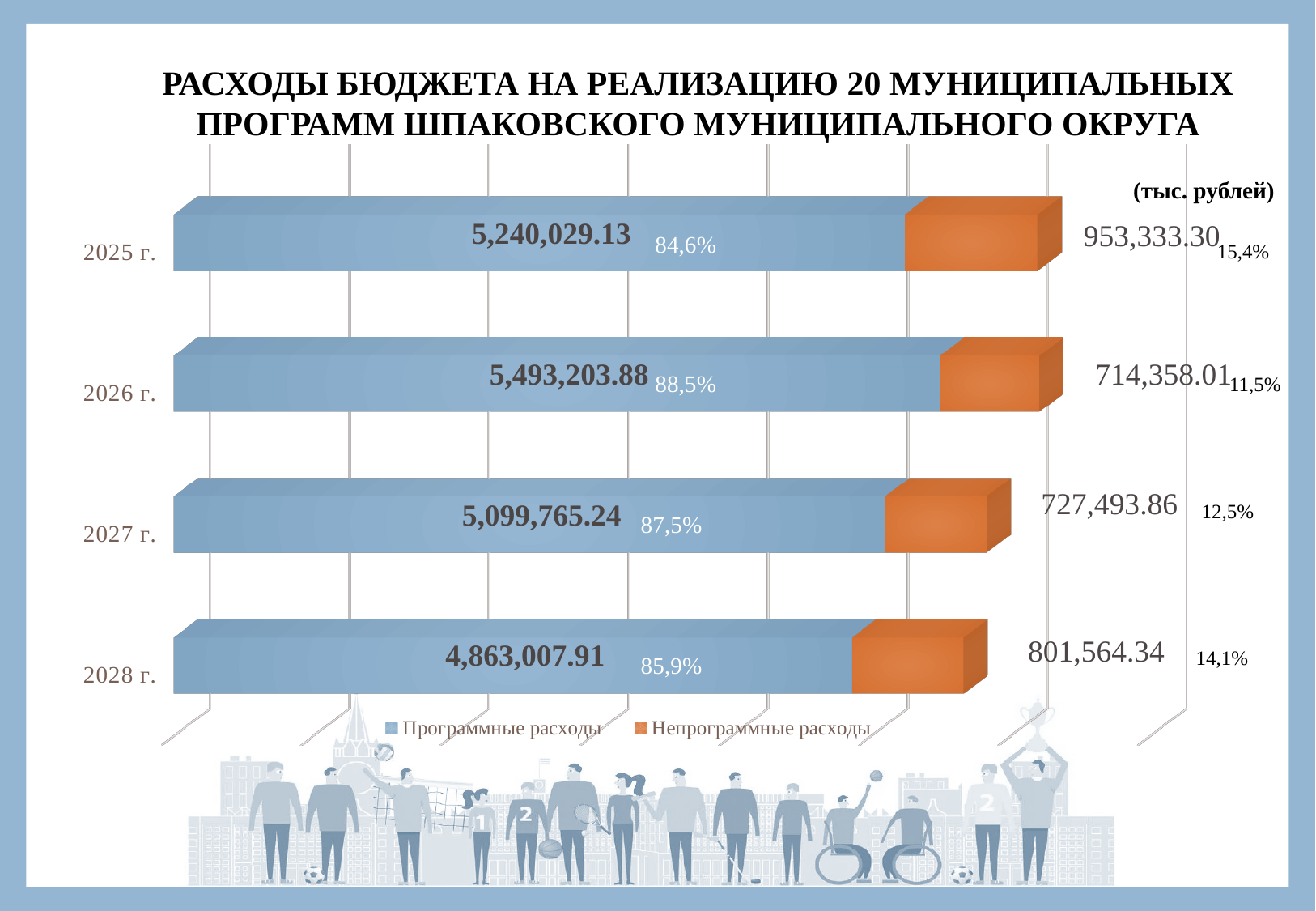
Which year has the highest value of Программные расходы? 2026 г. What kind of chart is shown on the slide? Stacked bar chart How many years are shown on the chart? 4 What is the total of the stacked bar for 2025 г.? 6,193,362.43 What percentage share is shown for Программные расходы in 2027 г.? 87,5% What is the difference between Программные расходы in 2026 г. and 2025 г.? 253,174.75 How many series does the legend list? 2 Which year has the lowest value of Непрограммные расходы? 2026 г. What is the value of Непрограммные расходы for 2026 г.? 714,358.01 What is the value of Программные расходы for 2025 г.? 5,240,029.13 Which is larger: Непрограммные расходы in 2027 г. or in 2028 г.? 2028 г. What is the value of Непрограммные расходы for 2028 г.? 801,564.34